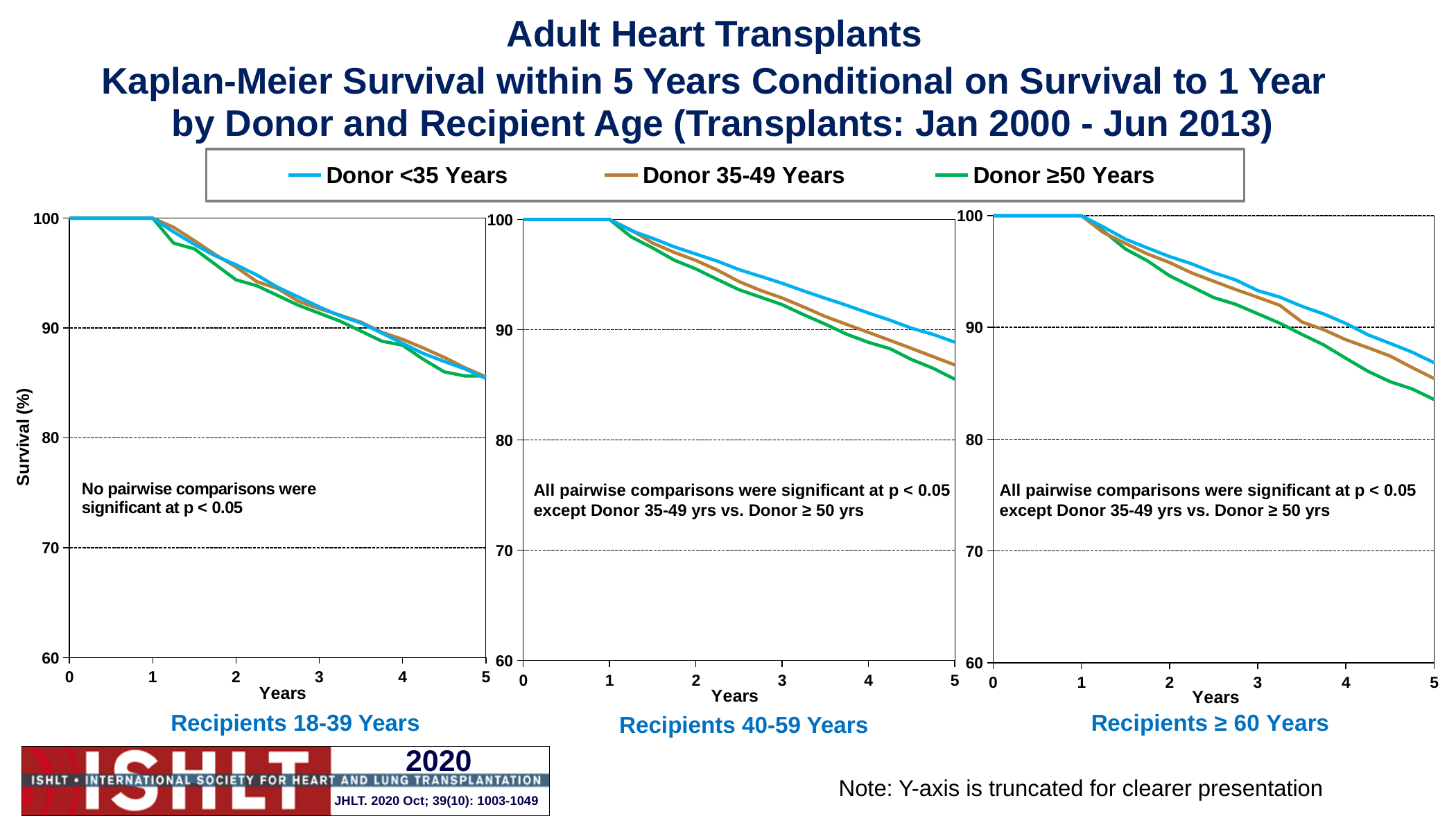
What kind of chart is used for the Recipients 18-39 Years panel? line chart How many charts are shown on the slide? 3 In the Recipients ≥ 60 Years chart, is the value for Donor ≥50 Years at year 4 greater or less than 90? less How many series does the legend list? 3 In the Recipients ≥ 60 Years chart, which series has the higher survival at year 5, Donor <35 Years or Donor ≥50 Years? Donor <35 Years In the Recipients 40-59 Years chart, is the value for Donor <35 Years at year 3 greater or less than 90? greater In the Recipients ≥ 60 Years chart, is the value for Donor ≥50 Years at year 5 greater or less than 90? less In the Recipients 40-59 Years chart, which series has the lowest survival at year 5? Donor ≥50 Years What is the label of the y-axis on the leftmost chart? Survival (%) In the Recipients ≥ 60 Years chart, which series has the highest survival at year 5? Donor <35 Years Which recipient age group is shown in the middle chart? Recipients 40-59 Years In the Recipients ≥ 60 Years chart, do the survival curves rise or fall as years increase? fall